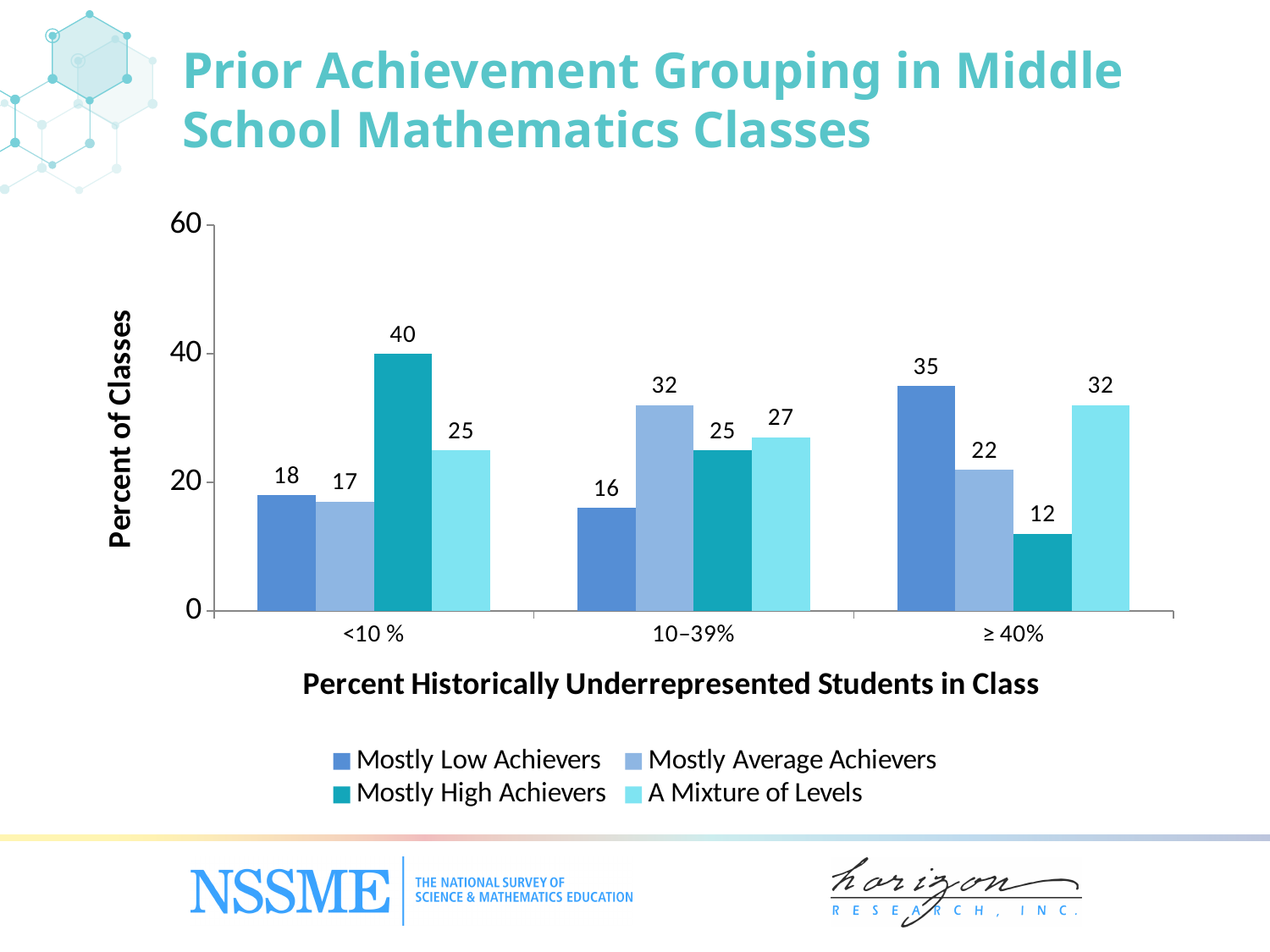
How many categories are shown on the x axis? 3 How many series does the legend list? 4 What is the value for Mostly Average Achievers in the 10–39% category? 32 Which is larger: A Mixture of Levels in the 10–39% category or in the ≥ 40% category? ≥ 40% What kind of chart is shown on the slide? Bar chart Which series has the highest value in the ≥ 40% category? Mostly Low Achievers What is the difference between Mostly High Achievers in the <10 % category and in the ≥ 40% category? 28 What percent of classes with <10 % historically underrepresented students are Mostly High Achievers? 40 Which series has the lowest value in the 10–39% category? Mostly Low Achievers Do the values for Mostly High Achievers rise or fall across the x axis from <10 % to ≥ 40%? Fall What is the label of the y axis? Percent of Classes What is the value for Mostly Low Achievers in the ≥ 40% category? 35